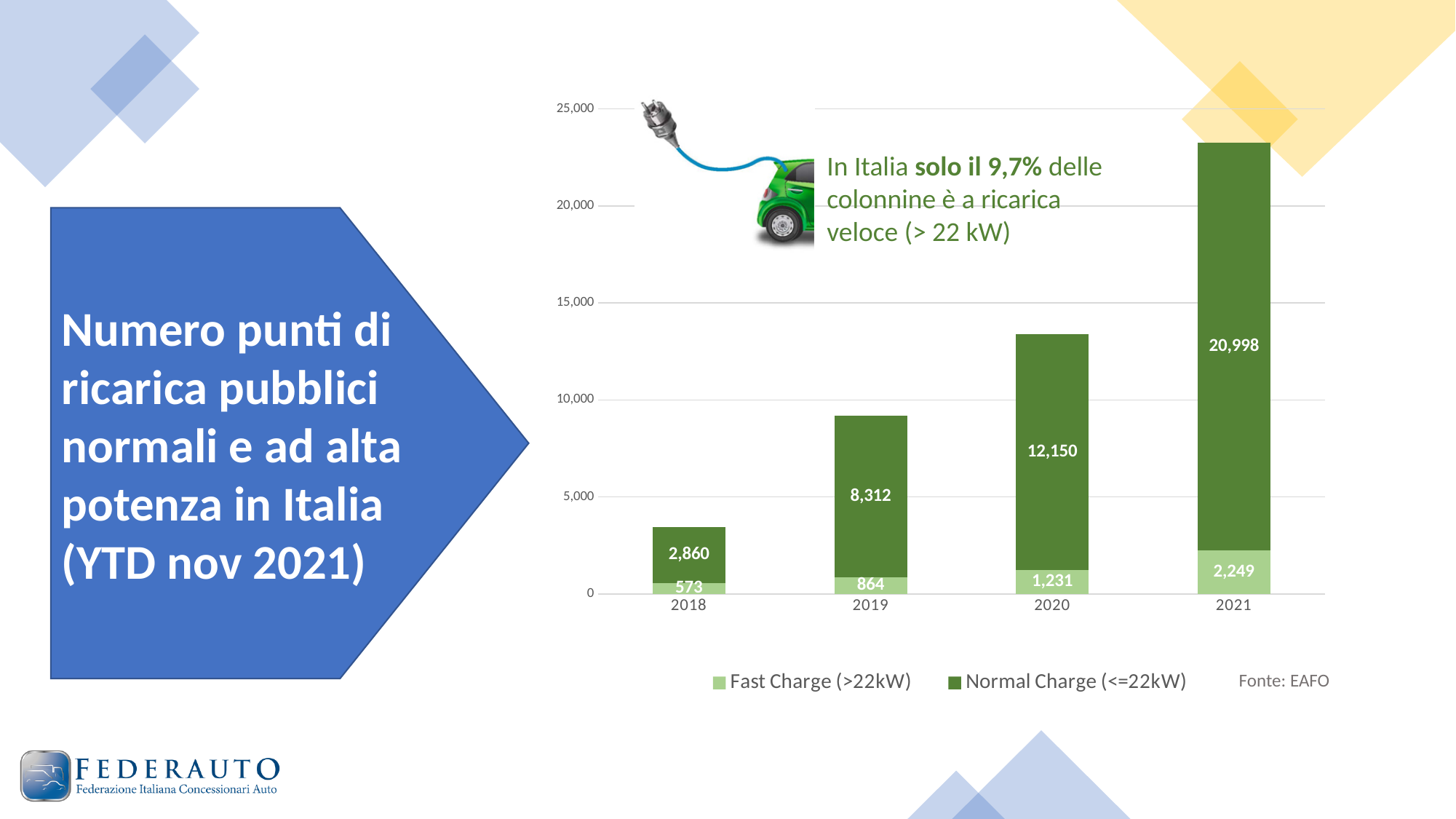
Which year has the lowest Fast Charge (>22kW) value? 2018 Which year has the highest Normal Charge (<=22kW) value? 2021 What is the difference between the Normal Charge (<=22kW) values for 2020 and 2019? 3,838 What is the Normal Charge (<=22kW) value for 2021? 20,998 Which is larger: the Fast Charge (>22kW) value for 2021 or the Normal Charge (<=22kW) value for 2018? Normal Charge (<=22kW) for 2018 What is the Fast Charge (>22kW) value for 2020? 1,231 What is the total of the stacked bar for 2019? 9,176 What kind of chart is shown on the slide? Stacked bar chart Is the total of the stacked bar for 2021 greater or less than 20,000? greater How many series does the legend list? 2 How many years are shown on the x axis? 4 What is the Fast Charge (>22kW) value for 2018? 573